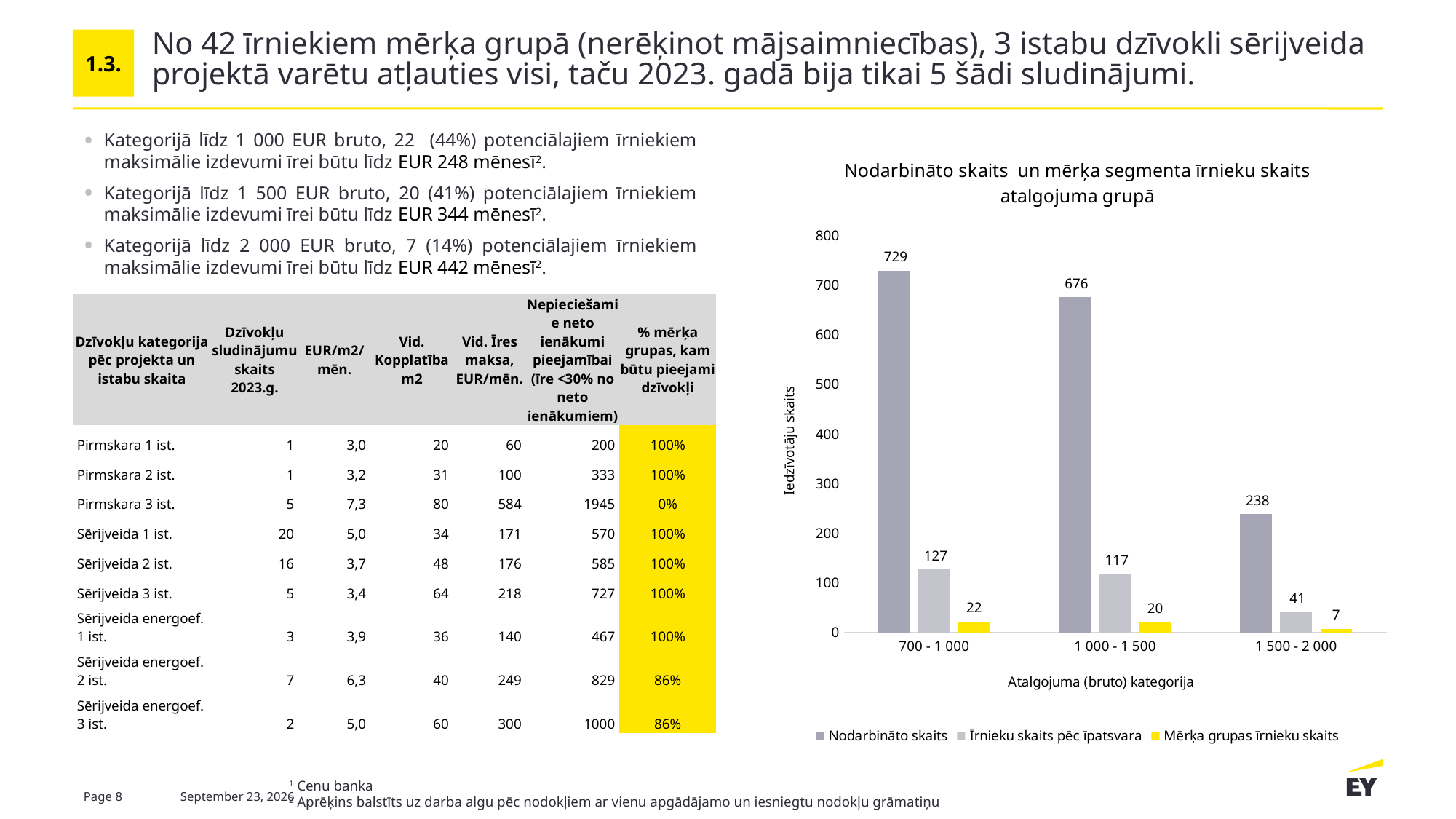
What is the value of Mērķa grupas īrnieku skaits for the 1 500 - 2 000 category? 7 How many salary categories are shown on the x axis? 3 What is the value of Nodarbināto skaits for the 700 - 1 000 category? 729 What type of chart is shown on the slide? Bar chart Which salary category has the highest Nodarbināto skaits? 700 - 1 000 What is the value of Īrnieku skaits pēc īpatsvara for the 1 000 - 1 500 category? 117 What is the title of the chart? Nodarbināto skaits un mērķa segmenta īrnieku skaits atalgojuma grupā Which is larger: Īrnieku skaits pēc īpatsvara for 700 - 1 000 or for 1 500 - 2 000? 700 - 1 000 What is the difference between Nodarbināto skaits for 700 - 1 000 and for 1 000 - 1 500? 53 Which salary category has the lowest Mērķa grupas īrnieku skaits? 1 500 - 2 000 How many series does the chart legend list? 3 Is the value of Nodarbināto skaits for 1 500 - 2 000 greater or less than 300? less